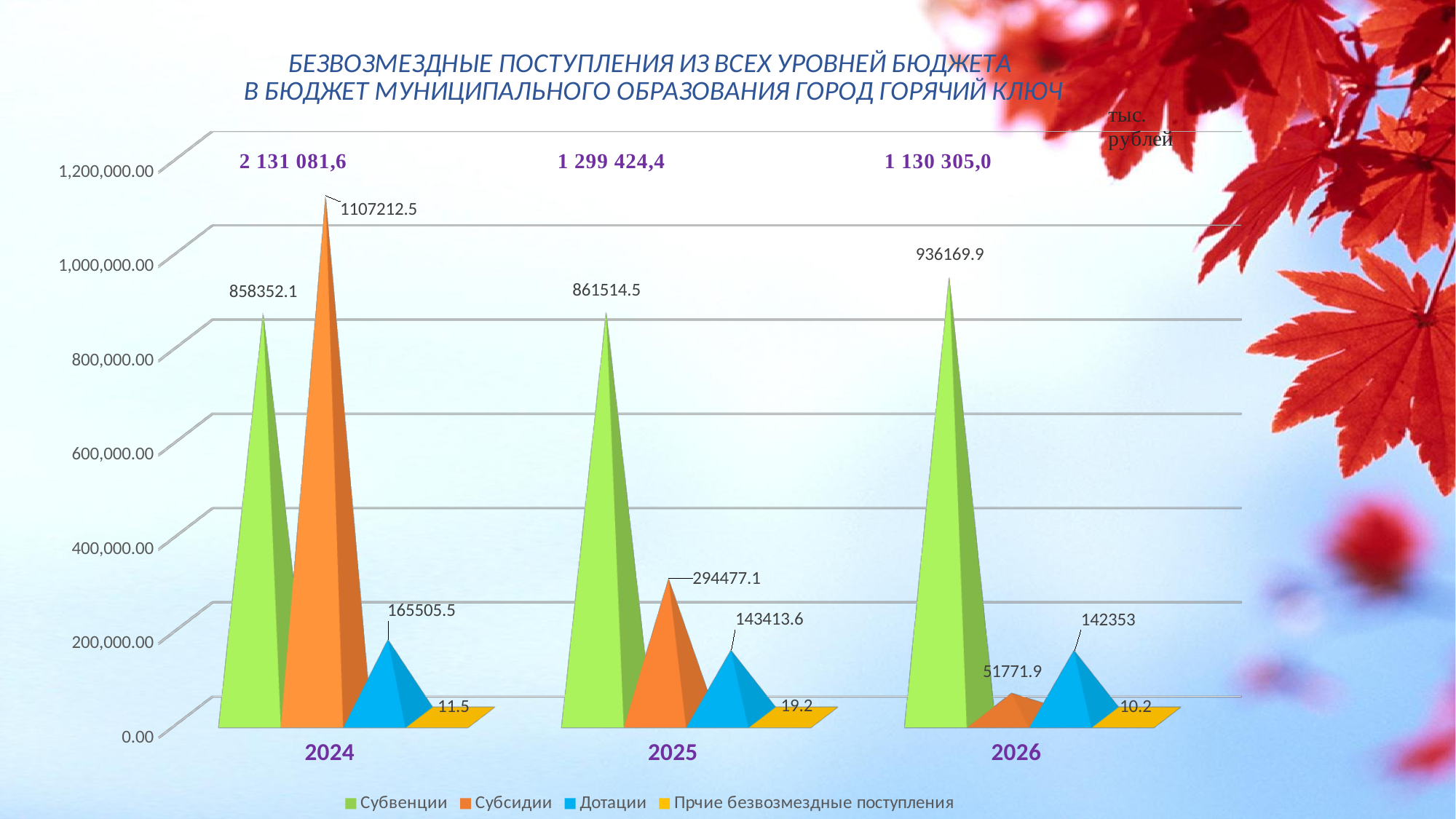
Is the value for Субсидии in 2026 greater or less than 200,000.00? less How many series does the legend list? 4 Which is larger: Субвенции in 2025 or Субсидии in 2025? Субвенции in 2025 What is the difference between the Субсидии values for 2024 and 2025? 812735.4 What is the value for Субвенции in 2026? 936169.9 How many years are shown on the x axis? 3 Which series has the lowest value in 2025? Прчие безвозмездные поступления What is the value for Субсидии in 2024? 1107212.5 Which series has the highest value in 2024? Субсидии What is the value for Дотации in 2025? 143413.6 Do the Субвенции values rise or fall from 2024 to 2026? rise What is the value for Прчие безвозмездные поступления in 2026? 10.2